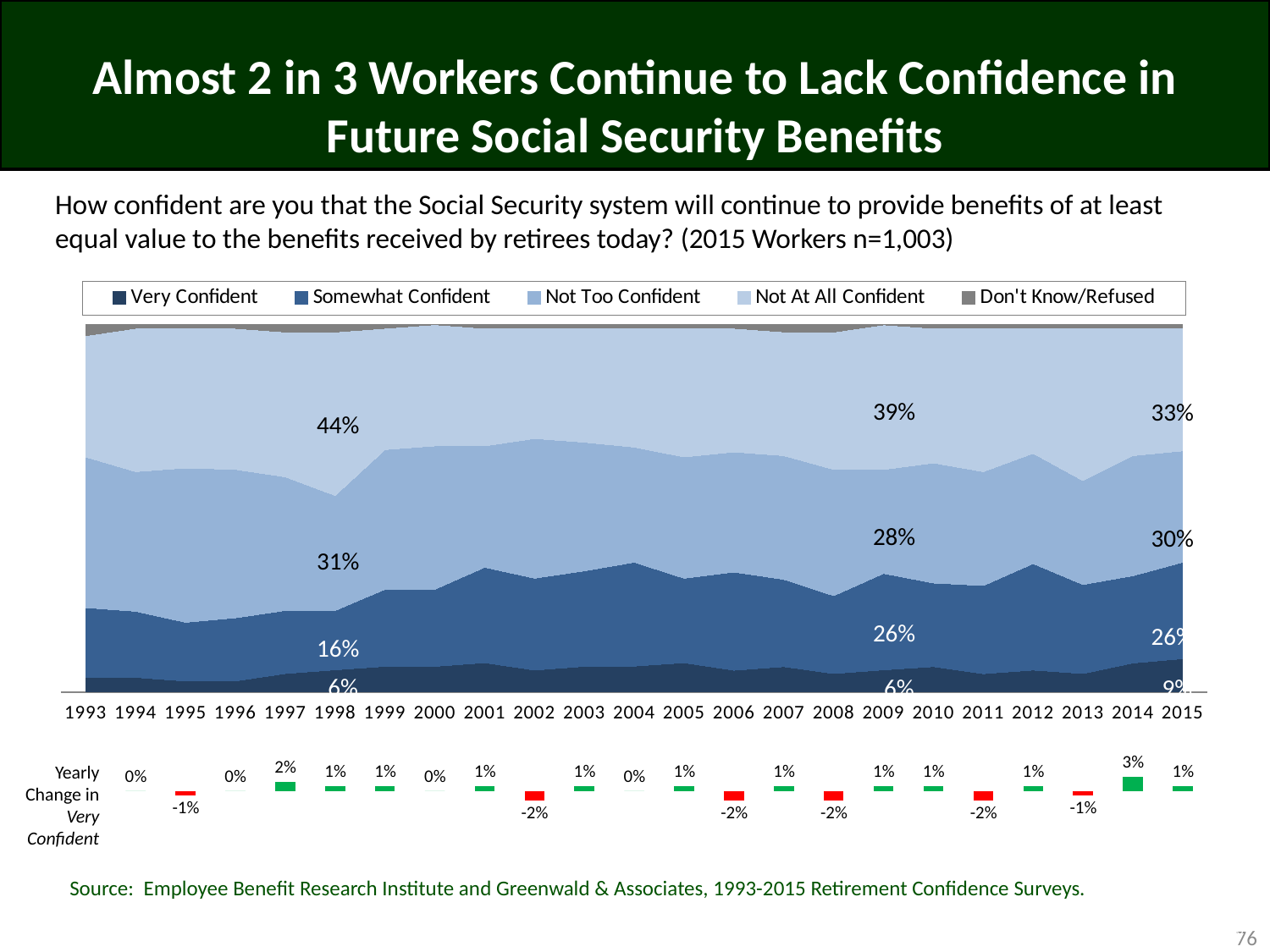
In the Yearly Change in Very Confident bar chart, what is the value for 2011? -2% How many series does the legend of the stacked area chart list? 5 In the stacked area chart, what percentage of workers were Not At All Confident in 2015? 33% What kind of chart is the main chart showing confidence levels from 1993 to 2015? Stacked area chart In the stacked area chart, what percentage of workers were Not Too Confident in 2009? 28% How many years are shown on the x axis of the stacked area chart? 23 In the stacked area chart, which series is shown at the top of the stack in the legend's last entry? Don't Know/Refused In the Yearly Change in Very Confident bar chart, which year shows the largest change? 2014 In the stacked area chart, what percentage of workers were Very Confident in 2009? 6% In the stacked area chart, what is the difference between the Not At All Confident share in 1998 and in 2015? 11% In the stacked area chart, what percentage of workers were Somewhat Confident in 1998? 16% In the stacked area chart, which is larger in 2015: the Not Too Confident share or the Somewhat Confident share? Not Too Confident